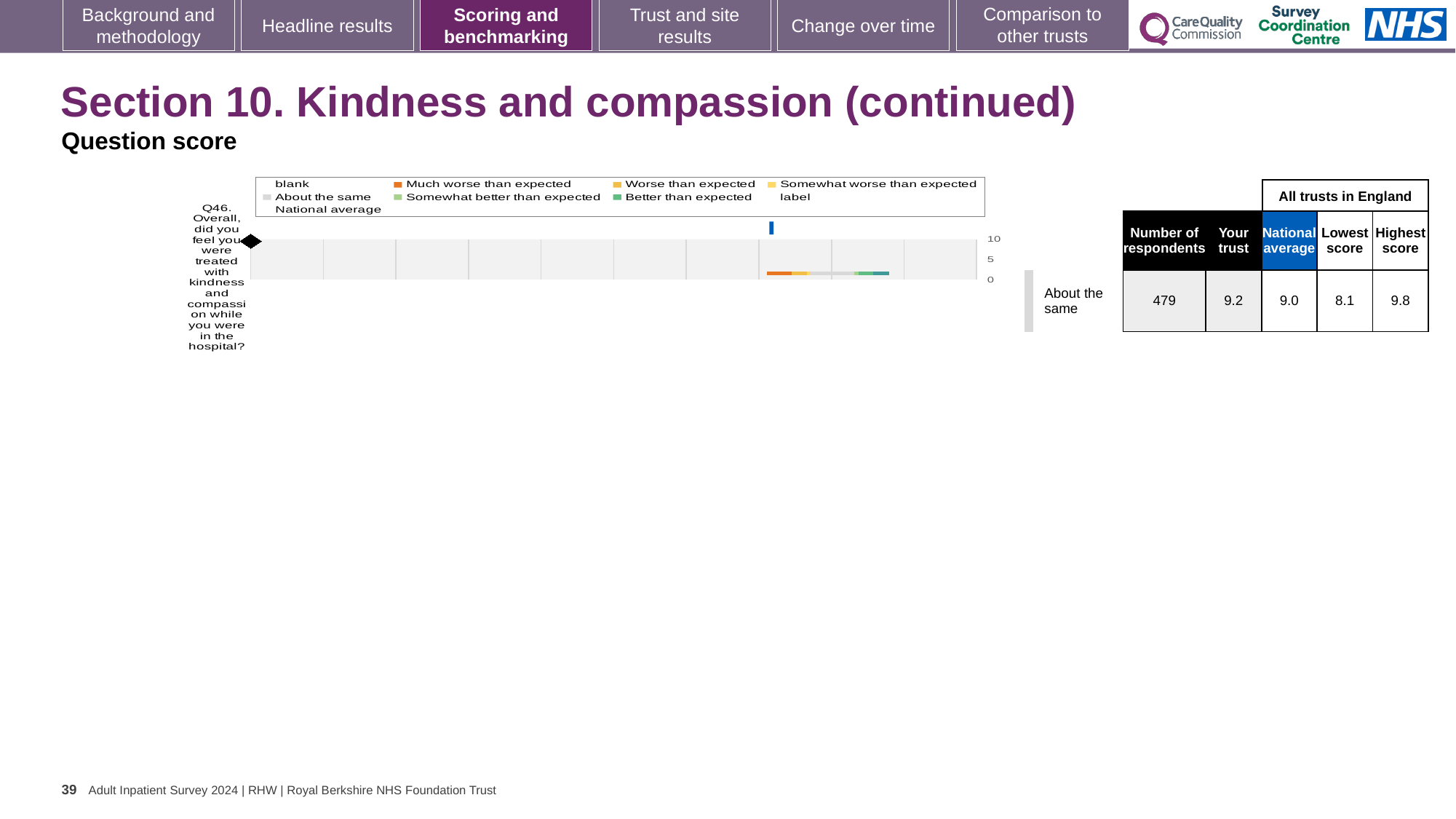
Is the Your trust score for Q46 greater or less than 5 on the chart axis? greater What is the Lowest score among all trusts in England for Q46? 8.1 Which is higher for Q46: Your trust score or the National average? Your trust How many questions are plotted on the chart? 1 What is the score for Your trust on Q46 (treated with kindness and compassion)? 9.2 What is the difference between the Highest score and the Lowest score for Q46? 1.7 What kind of chart is used to show the Q46 question score? bar chart What is the Highest score among all trusts in England for Q46? 9.8 What is the National average score for Q46? 9.0 Which benchmarking category is the trust's Q46 score placed in? About the same How many respondents answered Q46? 479 What is the difference between Your trust score and the National average for Q46? 0.2